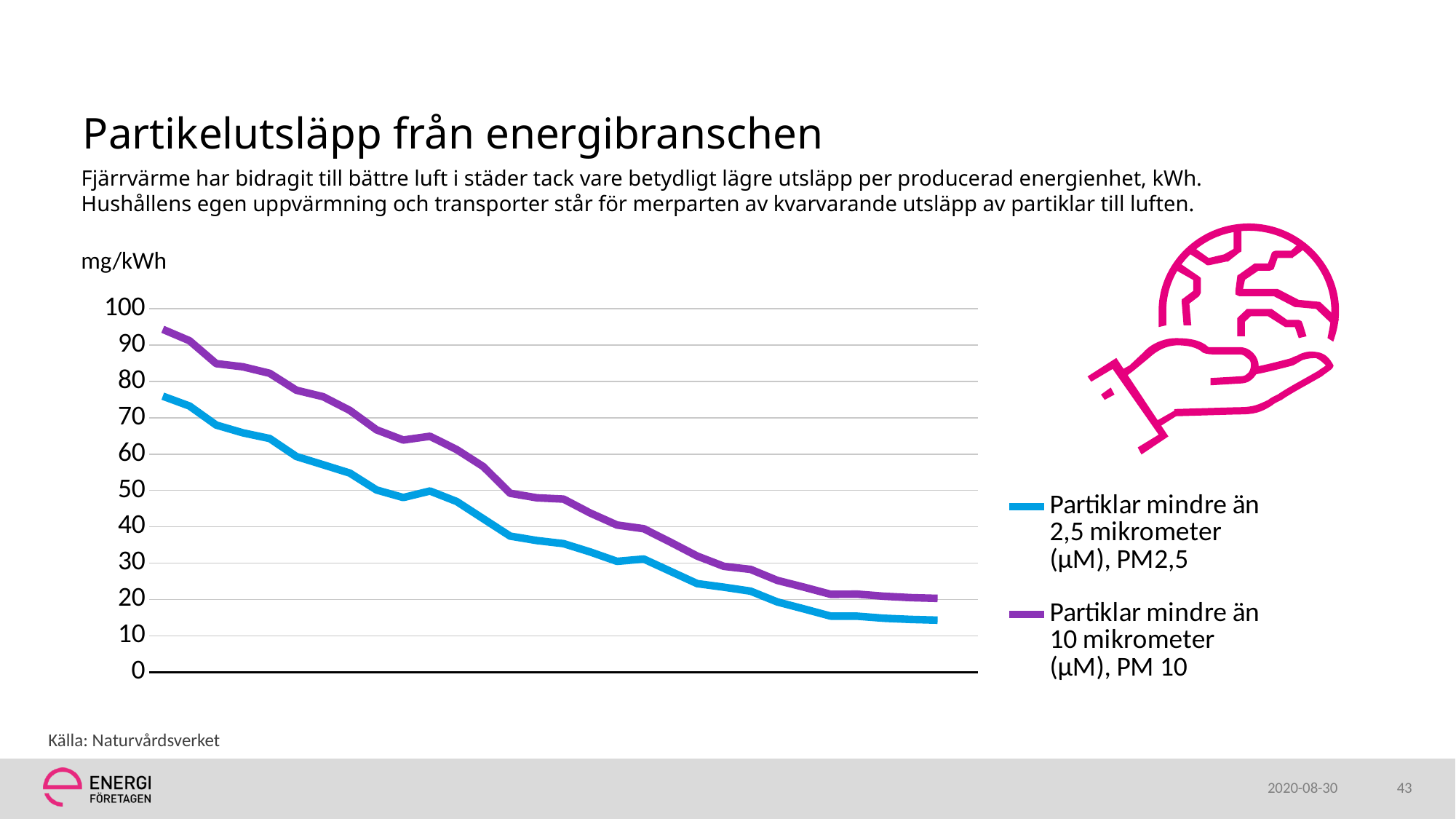
Is the first value of the PM 10 series greater or less than 90? greater Is the last value of the PM 10 series greater or less than 30? less Which series has the higher values throughout the chart, PM2,5 or PM 10? PM 10 Do the values for the PM 10 series rise or fall along the x axis? fall What is the title of the slide containing the chart? Partikelutsläpp från energibranschen What unit is shown on the y axis of the chart? mg/kWh Do the values for the PM2,5 series rise or fall along the x axis? fall Is the first value of the PM2,5 series greater or less than 80? less How many series does the legend list? 2 What kind of chart is shown on the slide? line chart